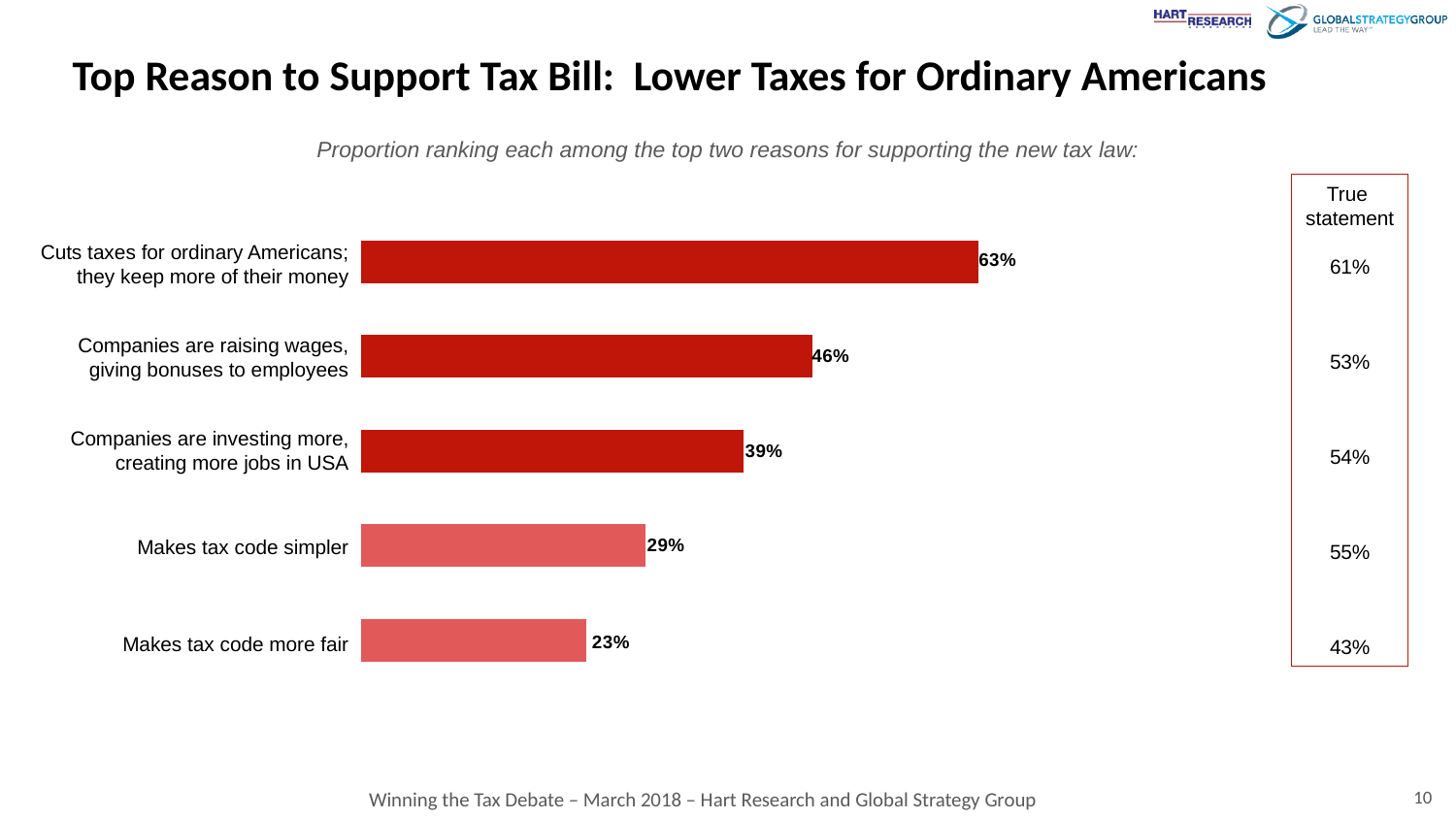
What is the value for "Companies are raising wages, giving bonuses to employees"? 46% What is the difference between the values for "Cuts taxes for ordinary Americans" and "Companies are raising wages, giving bonuses to employees"? 17 percentage points What is the value for "Makes tax code simpler"? 29% Which is larger: the value for "Companies are investing more, creating more jobs in USA" or "Makes tax code simpler"? Companies are investing more, creating more jobs in USA Which reason has the highest proportion ranking it among the top two? Cuts taxes for ordinary Americans; they keep more of their money What kind of chart is shown on the slide? Bar chart What is the value for "Makes tax code more fair"? 23% Which reason has the lowest proportion ranking it among the top two? Makes tax code more fair What is the difference between the values for "Makes tax code simpler" and "Makes tax code more fair"? 6 percentage points How many reasons are shown as bars in the chart? 5 What is the "True statement" percentage listed next to "Companies are investing more, creating more jobs in USA"? 54% What percentage ranked "Cuts taxes for ordinary Americans; they keep more of their money" among the top two reasons? 63%